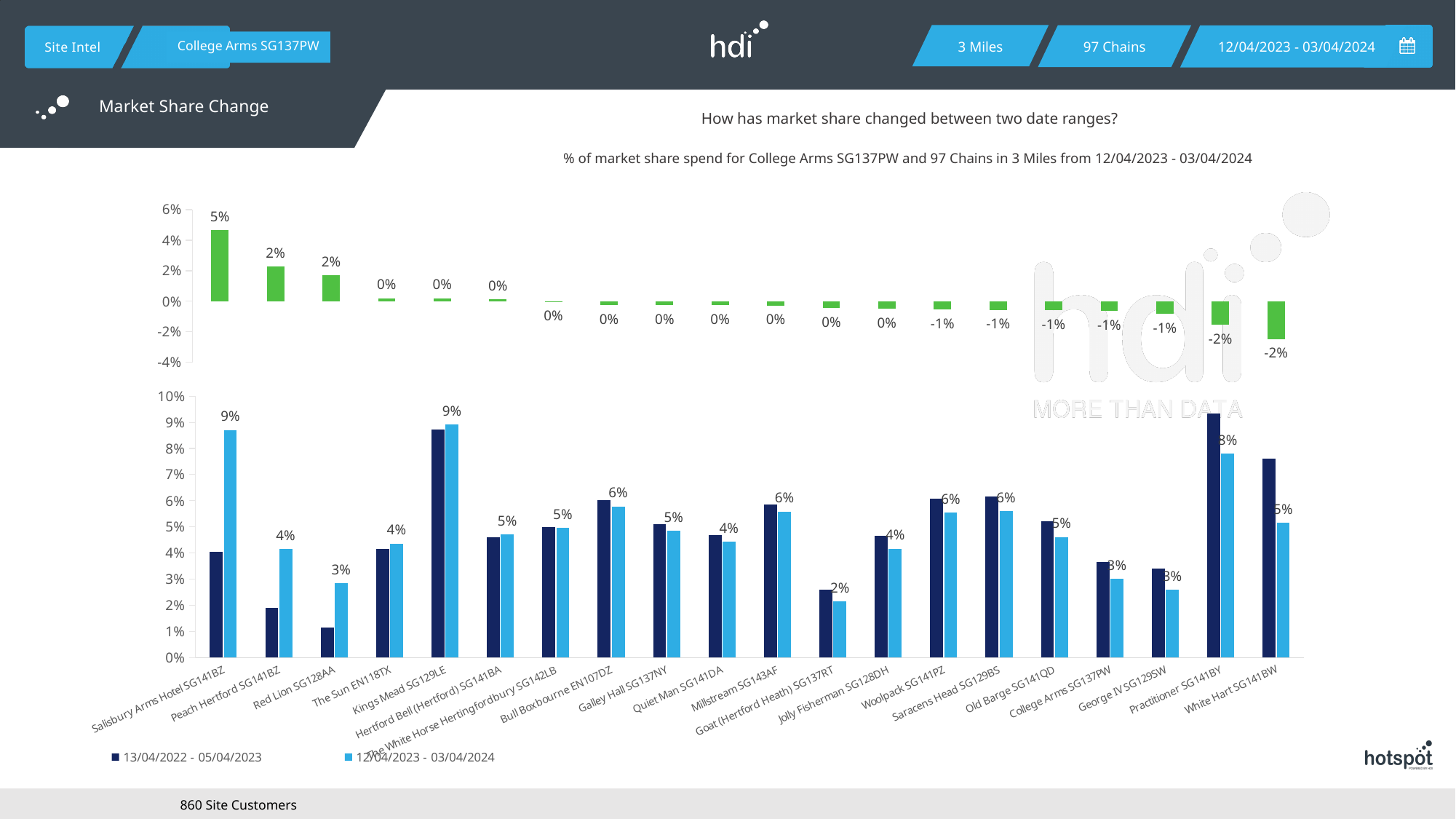
How many categories are plotted in the top chart? 20 In the bottom chart, for Salisbury Arms Hotel SG141BZ, which series has the larger value? 12/04/2023 - 03/04/2024 In the top chart, which category has the highest market share change? Salisbury Arms Hotel SG141BZ In the top chart, what is the market share change for Red Lion SG128AA? 2% What colour are the bars in the top chart? green In the bottom chart, what is the value for Kings Mead SG129LE in the 12/04/2023 - 03/04/2024 series? 9% In the bottom chart, what is the difference between Salisbury Arms Hotel SG141BZ and Red Lion SG128AA in the 12/04/2023 - 03/04/2024 series? 6% How many series does the legend of the bottom chart list? 2 In the bottom chart, what is the value for Goat (Hertford Heath) SG137RT in the 12/04/2023 - 03/04/2024 series? 2% In the bottom chart, is the value for Practitioner SG141BY in the 13/04/2022 - 05/04/2023 series greater or less than 9%? greater In the top chart, what is the market share change for White Hart SG141BW? -2% What kind of chart is the top chart showing market share change? bar chart